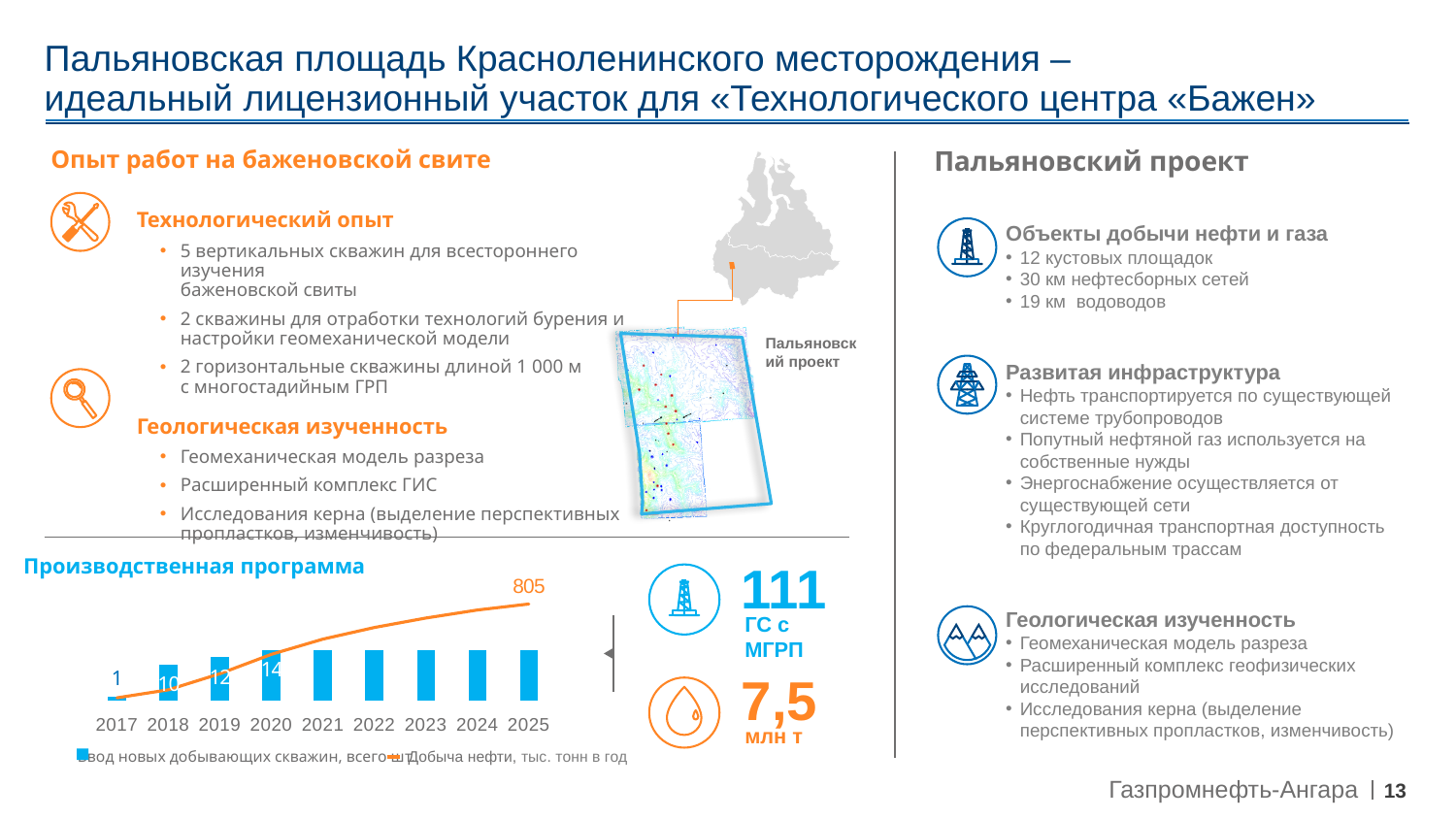
In the Производственная программа chart, which year has the lowest bar value? 2017 In the Производственная программа chart, how many years are shown on the x axis? 9 In the Производственная программа chart, what is the value of the bar for 2020? 14 In the Производственная программа chart, does the oil production line rise or fall from 2017 to 2025? Rises In the Производственная программа chart, what is the value of the bar for 2017? 1 In the Производственная программа chart, what is the difference between the bar values for 2018 and 2017? 9 What kind of chart is the Производственная программа chart? Combined bar and line chart In the Производственная программа chart, what value is printed on the orange line for oil production (Добыча нефти)? 805 In the Производственная программа chart, what is the value of the bar for 2018? 10 What is the title of the chart at the bottom left of the slide? Производственная программа In the Производственная программа chart, what is the value of the bar for 2019? 12 How many series does the legend of the Производственная программа chart list? 2